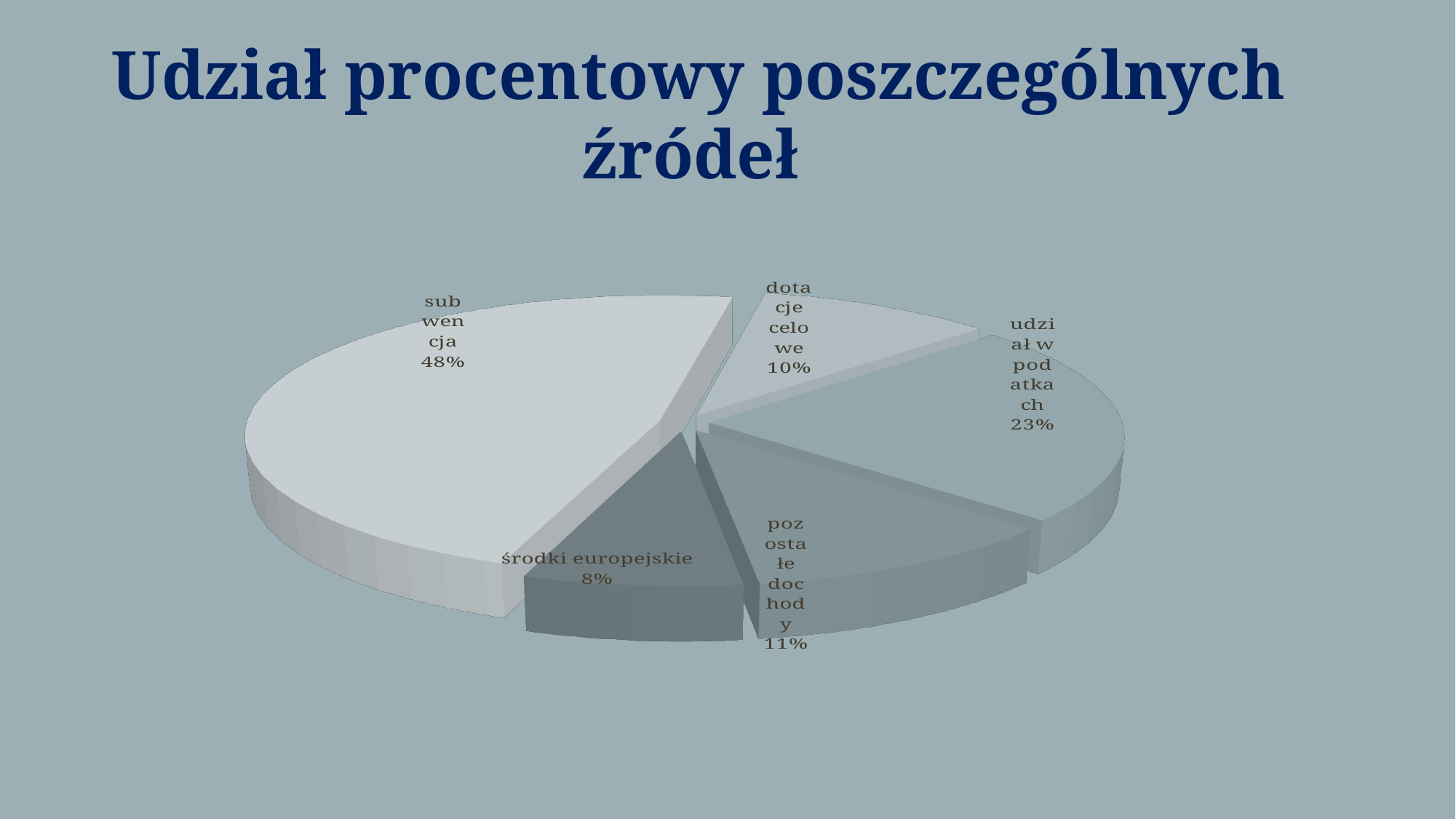
How many slices does the pie chart have? 5 Which is larger, the share for pozostałe dochody or the share for dotacje celowe? pozostałe dochody What kind of chart is shown on the slide? pie chart What share of the pie does dotacje celowe have? 10% What share of the pie does udział w podatkach have? 23% What share of the pie does pozostałe dochody have? 11% Which category has the smallest slice of the pie? środki europejskie What is the title of the slide? Udział procentowy poszczególnych źródeł What is the difference in percentage points between subwencja and udział w podatkach? 25 Which category has the largest slice of the pie? subwencja